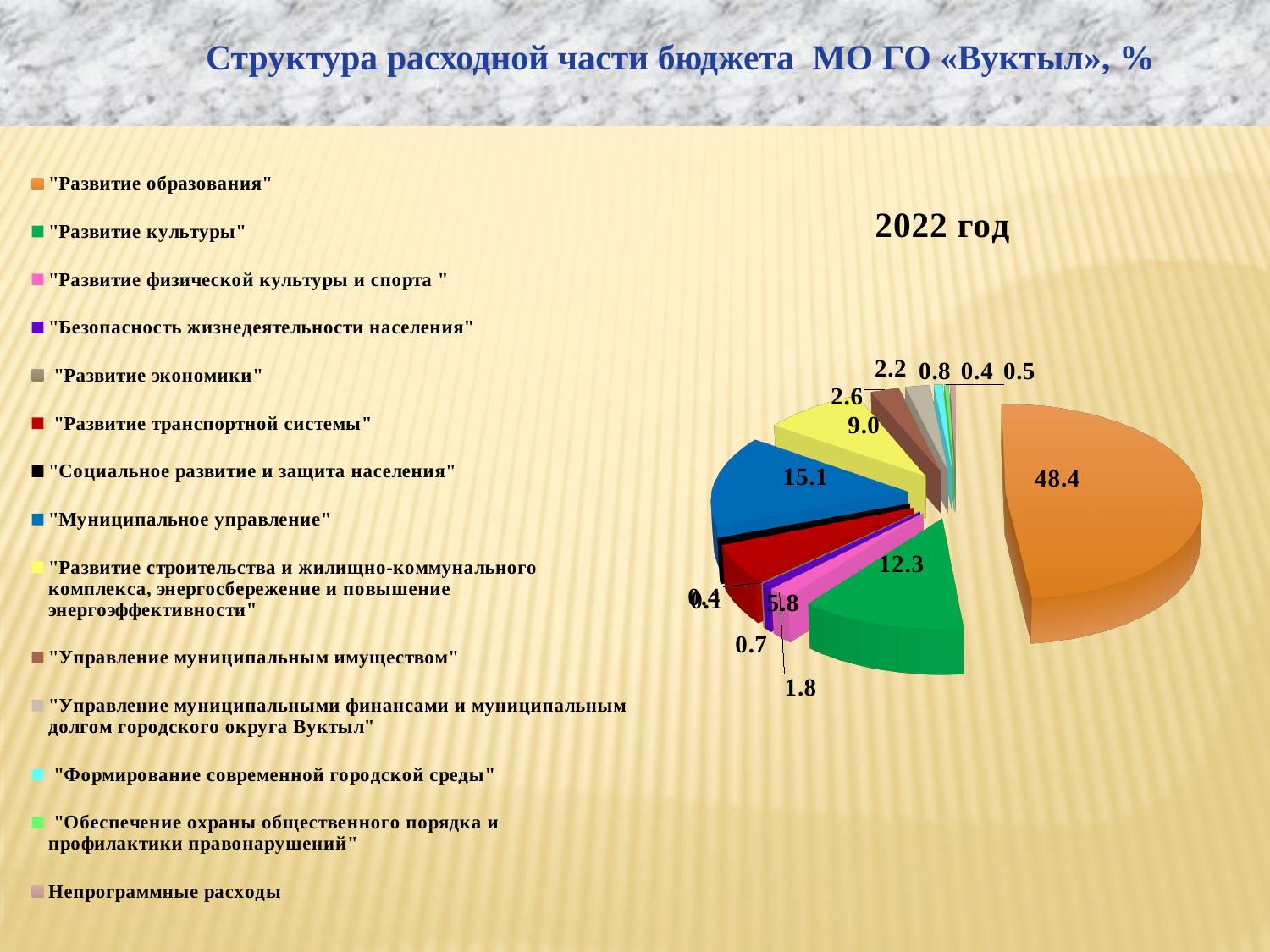
What kind of chart is shown on the slide? pie chart Which is larger, the value for "Муниципальное управление" or the value for "Развитие культуры"? "Муниципальное управление" What year does the chart title indicate? 2022 год What is the value for "Развитие транспортной системы"? 5.8 How many categories does the legend list? 14 Which category has the largest share of the budget expenditure? "Развитие образования" What is the value for "Развитие образования"? 48.4 What is the difference between the values for "Развитие образования" and "Развитие культуры"? 36.1 What is the value for "Развитие физической культуры и спорта"? 1.8 What is the value for "Развитие культуры"? 12.3 What is the value for "Развитие строительства и жилищно-коммунального комплекса, энергосбережение и повышение энергоэффективности"? 9.0 What is the value for "Муниципальное управление"? 15.1